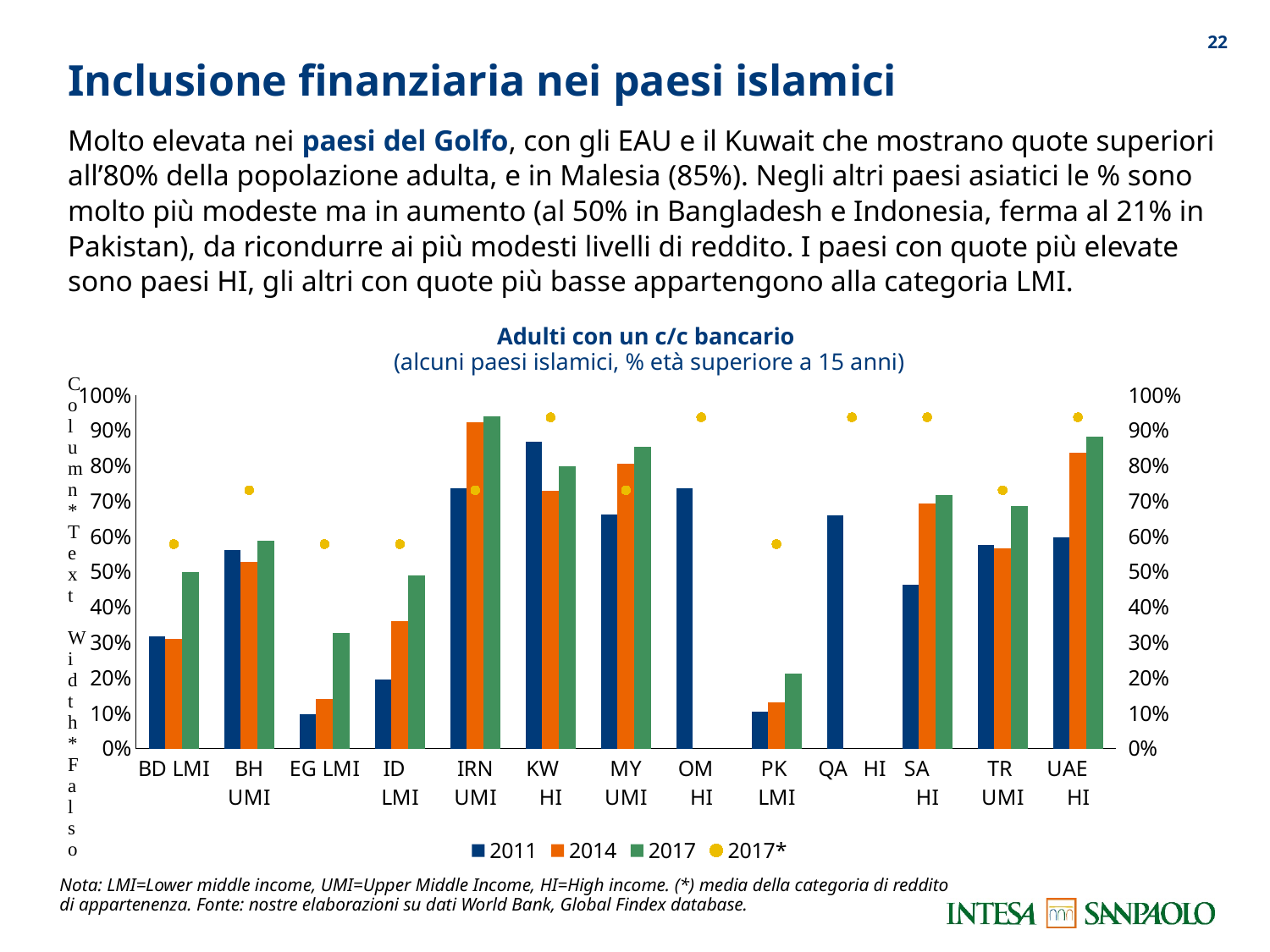
Which country has the highest 2017 bar? IRN UMI Which country has the lowest 2017 bar? PK LMI What is the title of the chart? Adulti con un c/c bancario Which country has the highest 2011 bar? KW HI Is the 2017 value for EG LMI greater or less than 30%? greater Is the 2011 value for SA HI greater or less than 50%? less How many countries are shown on the x axis? 13 Is the 2017 value for UAE HI greater or less than 80%? greater How many series does the legend list? 4 For ID LMI, do the values rise or fall from 2011 to 2017? rise Which is larger, the 2017 value for BD LMI or the 2017 value for EG LMI? BD LMI What kind of chart is shown on the slide? bar chart